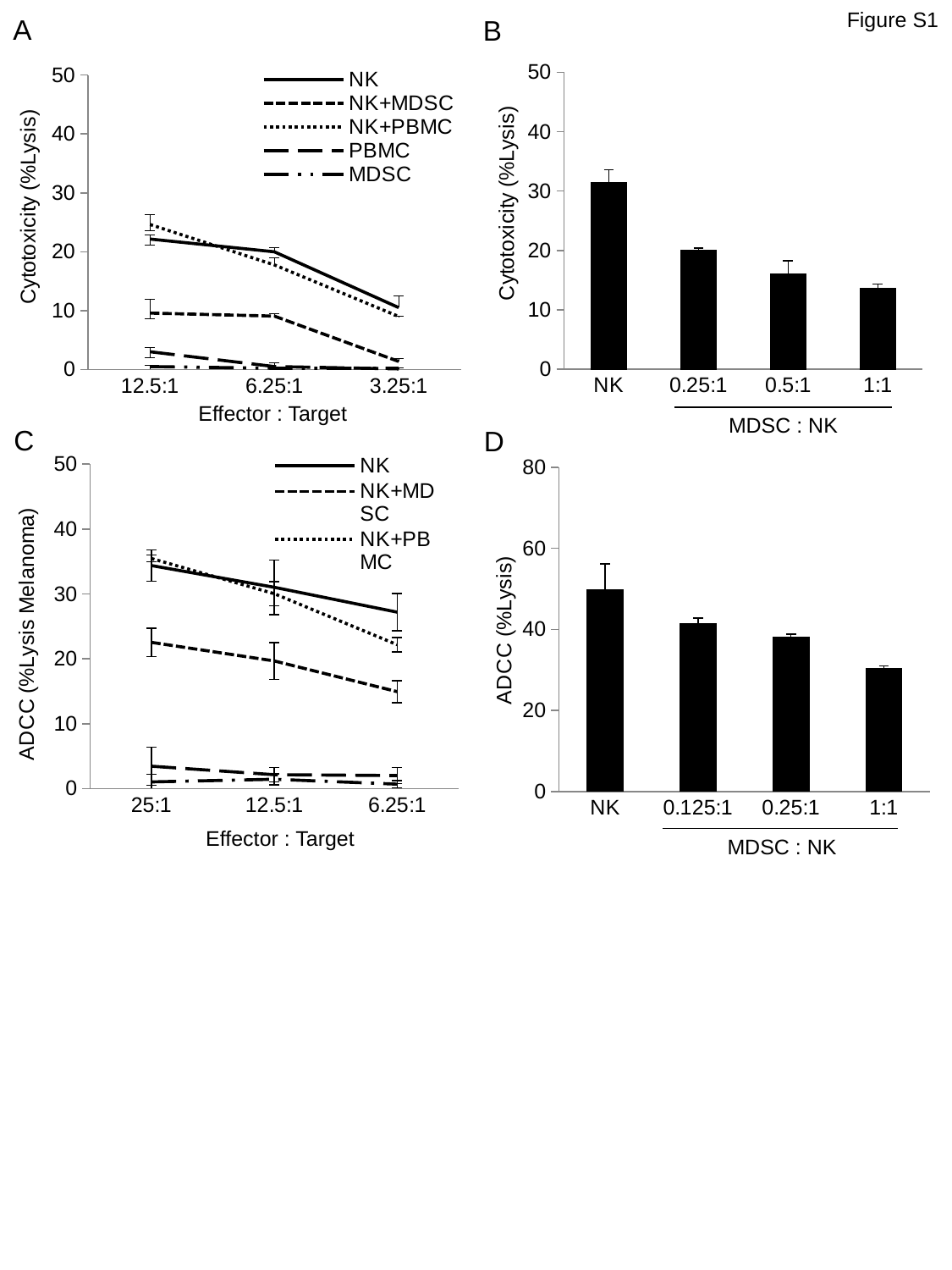
In chart A (top left), does the NK series rise or fall as the Effector : Target ratio goes from 12.5:1 to 3.25:1? fall In chart D (bottom right), which category has the lowest ADCC? 1:1 In chart B (top right), is the value for 1:1 greater or less than 20? less In chart C (bottom left), is the value for NK at 25:1 greater or less than 30? greater In chart B (top right), which category has the highest cytotoxicity? NK In chart D (bottom right), is the value for NK greater or less than 40? greater How many bars are shown in chart B (top right)? 4 What kind of chart is chart B (top right)? bar chart How many series does the legend of chart C (bottom left) list? 3 What kind of chart is chart A (top left)? line chart How many series does the legend of chart A (top left) list? 5